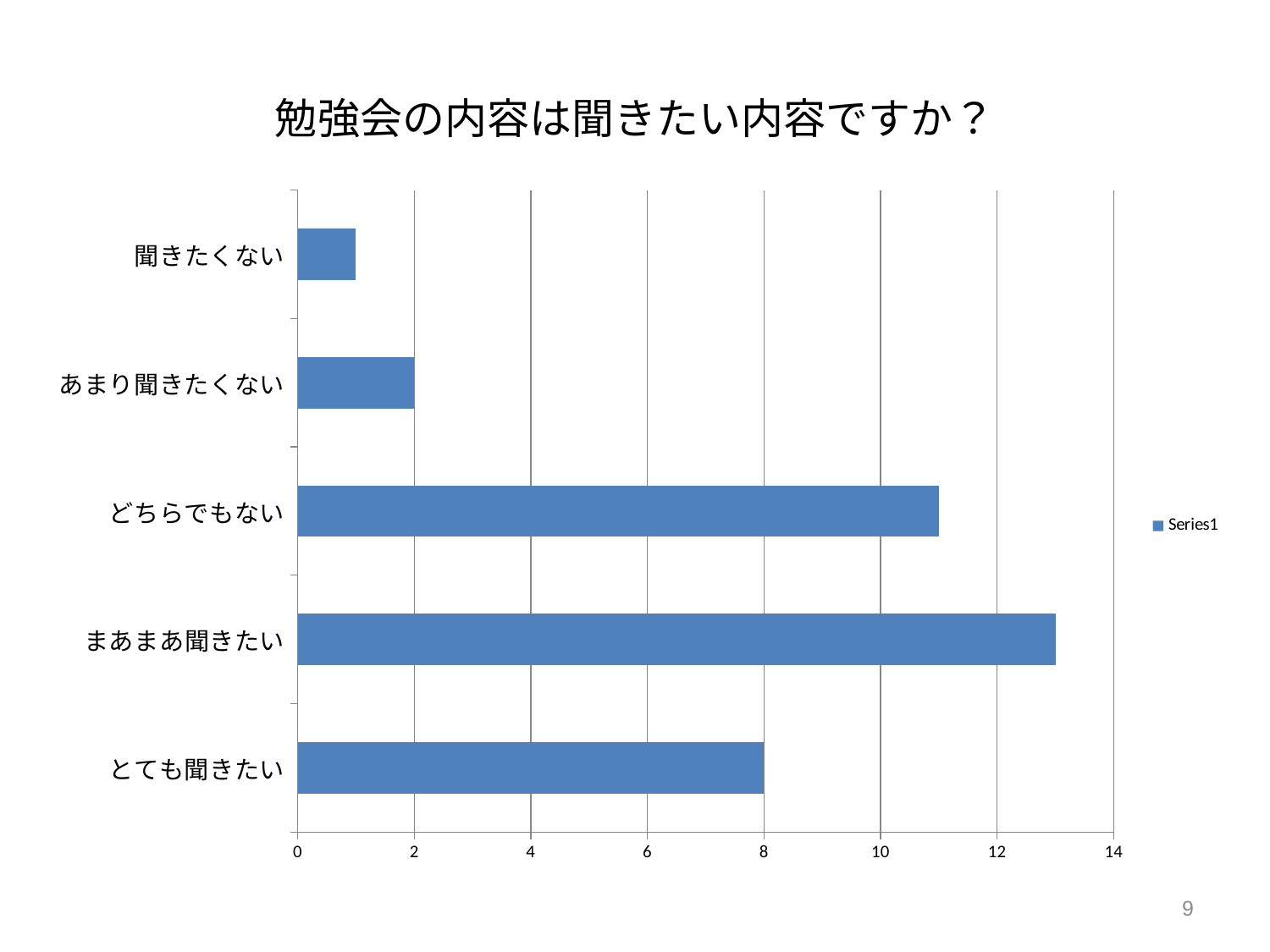
How many series does the legend list? 1 Which category has the lowest value? 聞きたくない Is the value for どちらでもない greater or less than 10? greater Which is larger, the value for どちらでもない or the value for とても聞きたい? どちらでもない How many categories are shown in the chart? 5 What is the value for とても聞きたい? 8 Is the value for まあまあ聞きたい greater or less than 12? greater Is the value for 聞きたくない greater or less than 2? less What kind of chart is shown on the slide? bar chart Which category has the highest value? まあまあ聞きたい What is the value for あまり聞きたくない? 2 What is the difference between the values for とても聞きたい and あまり聞きたくない? 6